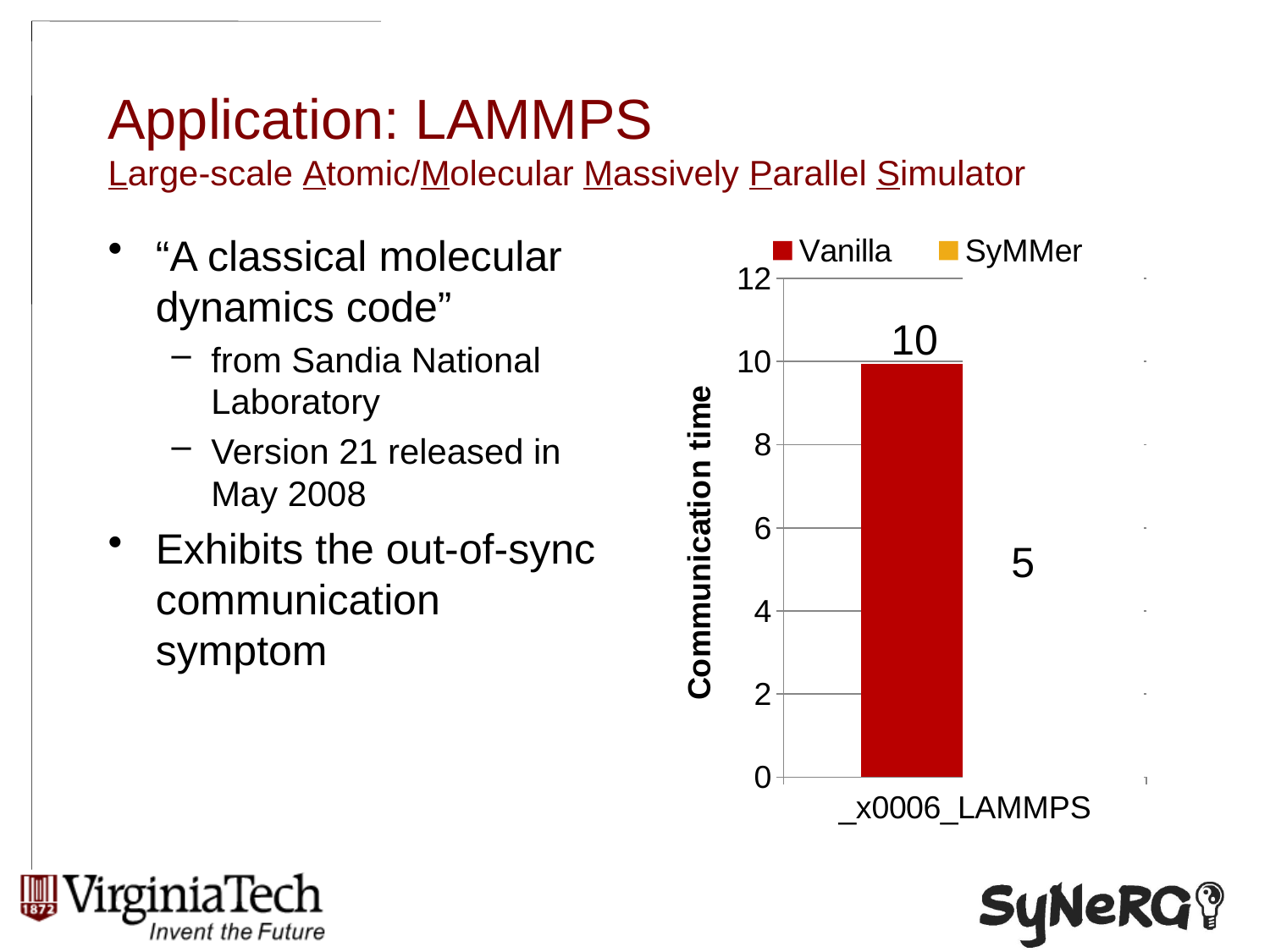
How many series does the legend list? 2 What is the highest value shown on the y axis? 12 Is the Vanilla communication time greater or less than 8? greater What is the SyMMer communication time for LAMMPS? 5 How many categories are shown on the x axis? 1 What colour represents the Vanilla series in the legend? Red Which series has the lowest communication time? SyMMer What is the Vanilla communication time for LAMMPS? 10 What is the difference between the Vanilla and SyMMer communication times? 5 What kind of chart is shown on the slide? Bar chart Which series has the higher communication time, Vanilla or SyMMer? Vanilla What is the label of the y axis? Communication time